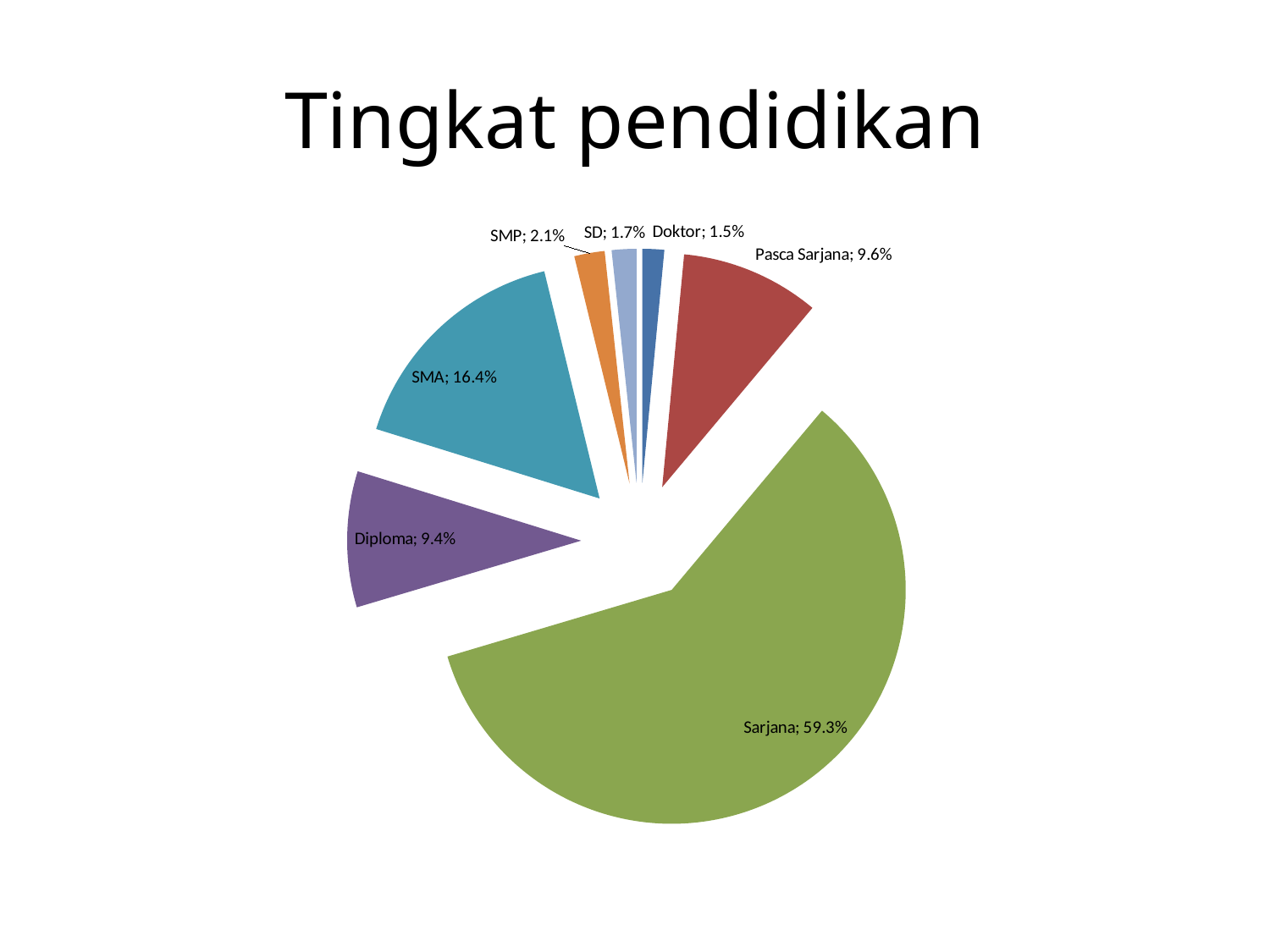
What is the share for Doktor? 1.5% What is the share for Pasca Sarjana? 9.6% What is the difference between the shares of SMP and SD? 0.4% Which category has the largest slice? Sarjana What is the difference between the shares of SMA and Diploma? 7.0% What type of chart is shown on the slide? Pie chart What is the share for Sarjana? 59.3% How many categories are shown in the pie chart? 7 What is the title of the chart? Tingkat pendidikan Which is larger, the share for Pasca Sarjana or the share for Diploma? Pasca Sarjana What is the share for SMA? 16.4% Which category has the smallest slice? Doktor